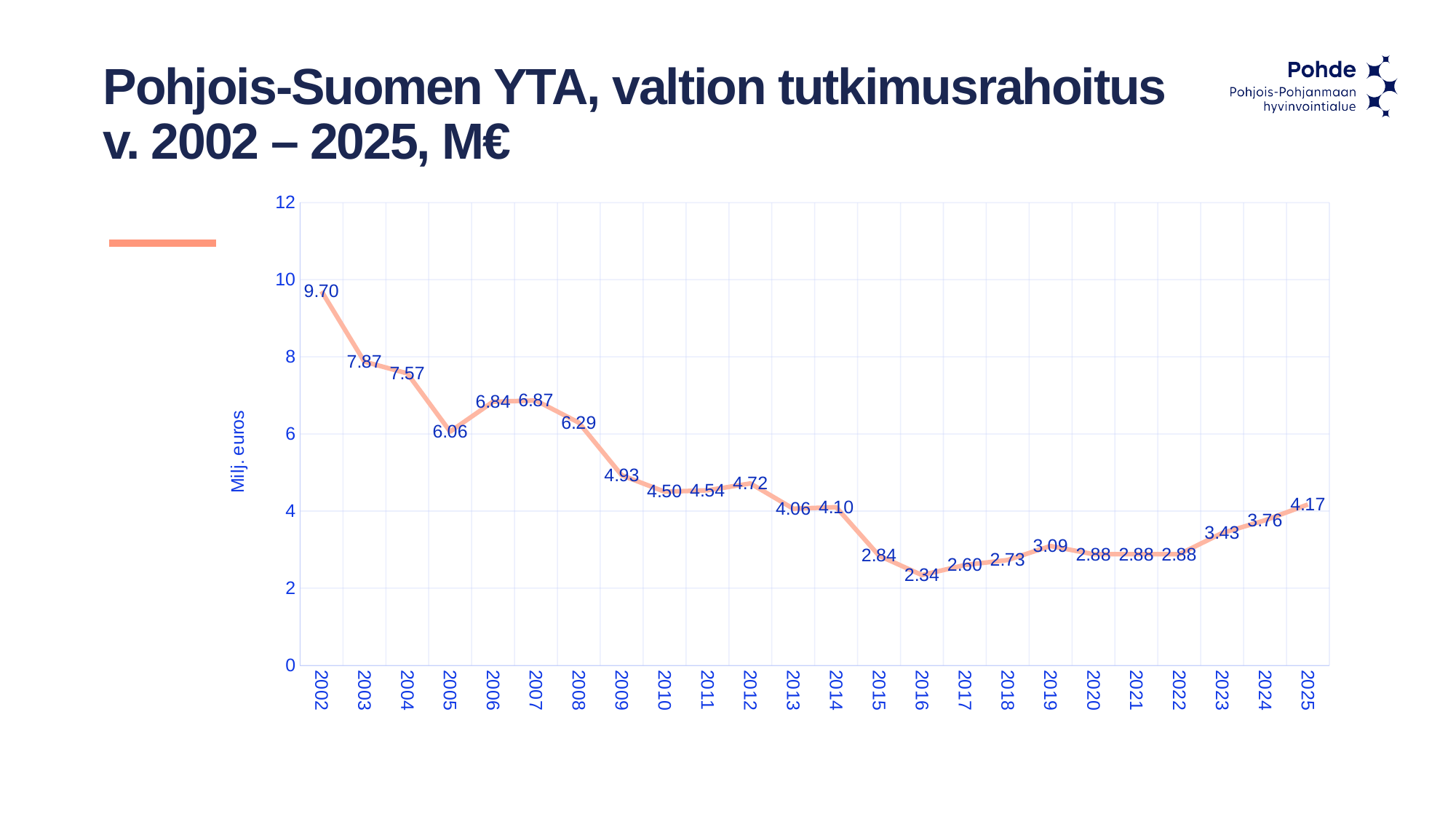
Which year has the highest value? 2002 What is the difference between the values for 2002 and 2025? 5.53 What is the difference between the values for 2024 and 2023? 0.33 Which year has the lowest value? 2016 What kind of chart is shown? line chart What is the value for 2002? 9.70 What is the value for 2016? 2.34 How many years are plotted on the x axis? 24 What is the value for 2025? 4.17 Do the values generally rise or fall from 2002 to 2016? fall Which is larger, the value for 2008 or the value for 2009? 2008 What is the y-axis label? Milj. euros